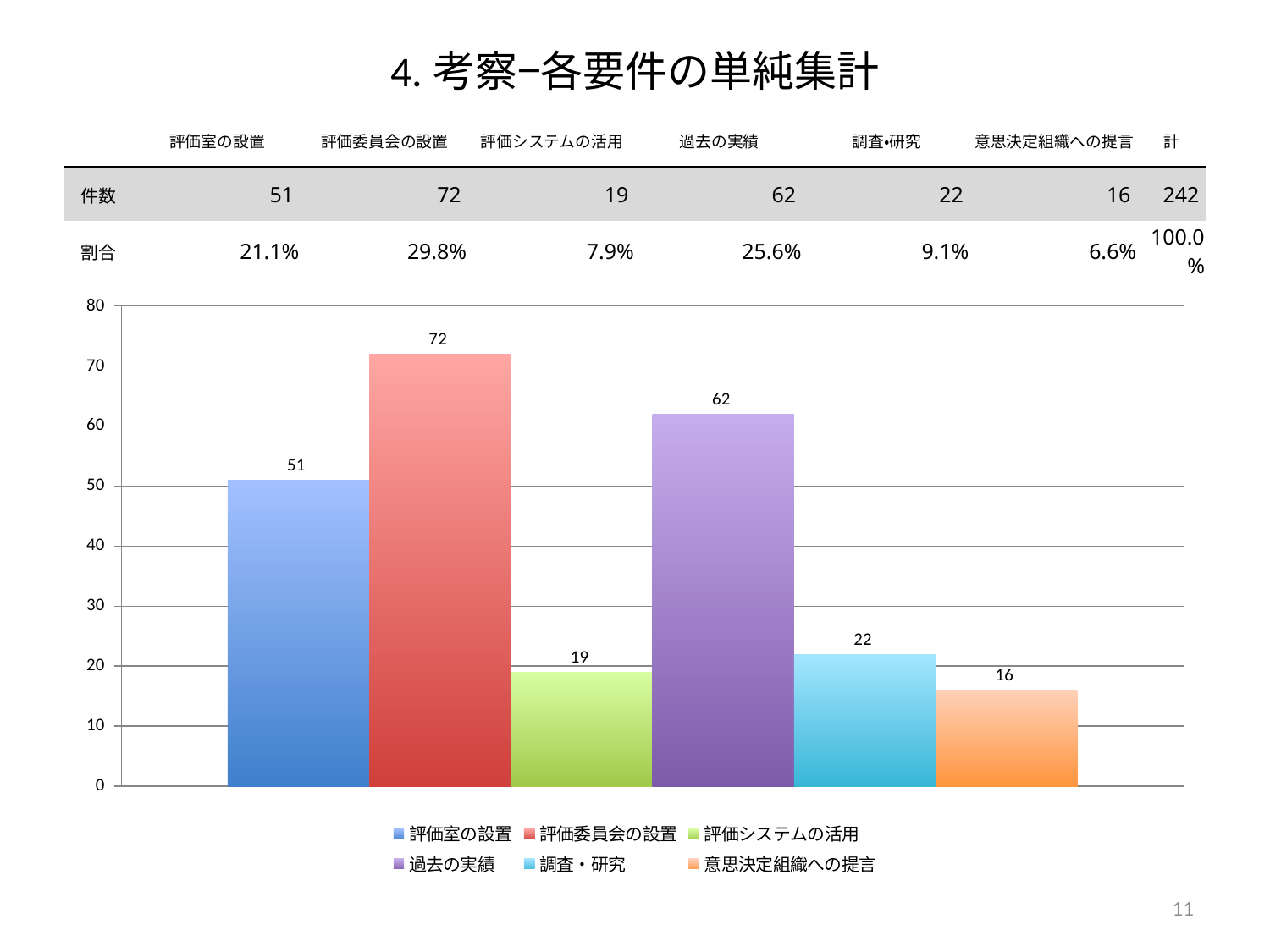
What is the value for 評価システムの活用 in the chart? 19 Which category has the lowest value in the chart? 意思決定組織への提言 How many entries does the chart legend list? 6 What is the difference between the values for 評価室の設置 and 調査・研究? 29 How many bars are plotted in the chart? 6 What is the difference between the values for 評価委員会の設置 and 過去の実績? 10 What is the value for 意思決定組織への提言 in the chart? 16 What is the value for 評価委員会の設置 in the chart? 72 Which is larger, the value for 評価室の設置 or the value for 過去の実績? 過去の実績 Is the value for 調査・研究 greater or less than 30? less What kind of chart is shown on the slide? bar chart Which category has the highest value in the chart? 評価委員会の設置